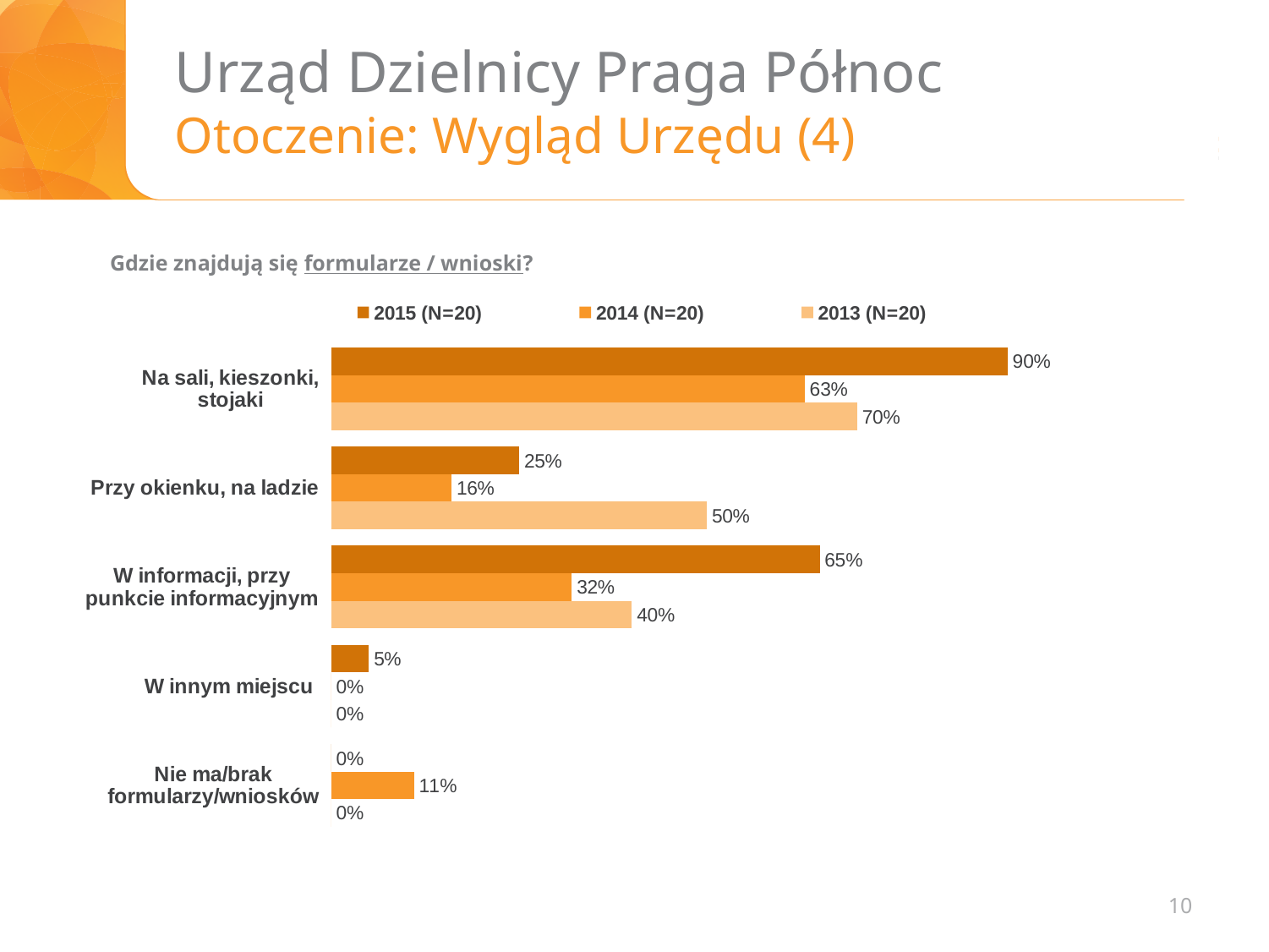
What is the value for "Na sali, kieszonki, stojaki" in the 2015 (N=20) series? 90% How many categories are shown on the chart? 5 What is the value for "W informacji, przy punkcie informacyjnym" in the 2014 (N=20) series? 32% What is the value for "Przy okienku, na ladzie" in the 2013 (N=20) series? 50% How many series does the legend list? 3 What kind of chart is shown on the slide? Bar chart Which is larger for "Przy okienku, na ladzie": the 2015 (N=20) value or the 2013 (N=20) value? 2013 (N=20) What is the value for "Nie ma/brak formularzy/wniosków" in the 2014 (N=20) series? 11% Which category has the highest value in the 2015 (N=20) series? Na sali, kieszonki, stojaki What question does the chart answer, as stated above it? Gdzie znajdują się formularze / wnioski? What is the difference between the 2015 (N=20) and 2014 (N=20) values for "Na sali, kieszonki, stojaki"? 27%